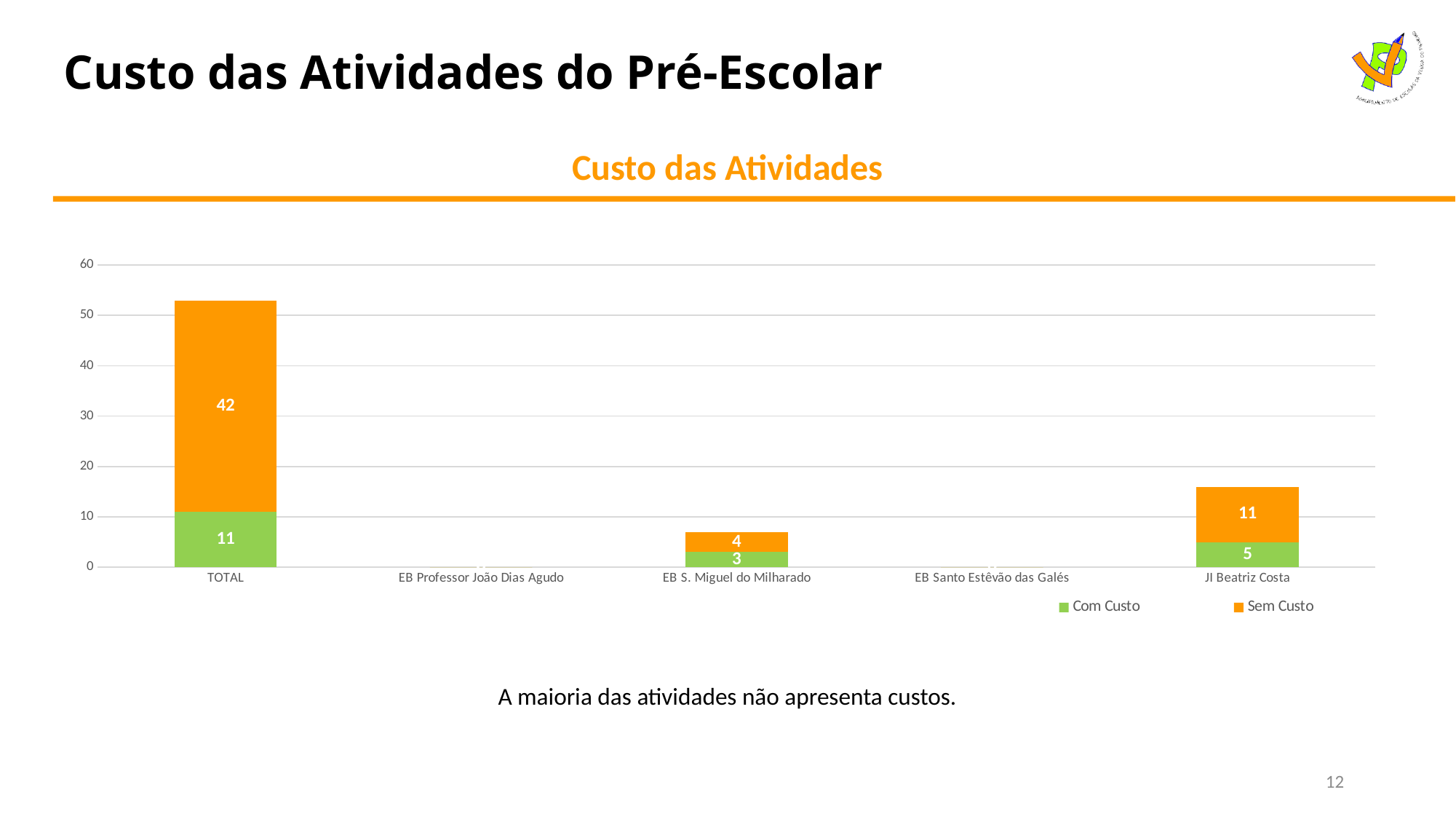
What is the Com Custo value for JI Beatriz Costa? 5 How many series does the legend list? 2 Which school (excluding TOTAL) has the highest Sem Custo value? JI Beatriz Costa What is the Sem Custo value for EB S. Miguel do Milharado? 4 What is the Com Custo value for TOTAL? 11 What is the total of the stacked bar for EB S. Miguel do Milharado? 7 What is the total of the stacked bar for JI Beatriz Costa? 16 Is the total stacked bar for TOTAL greater or less than 50? greater What is the difference between the Sem Custo and Com Custo values for JI Beatriz Costa? 6 Which is larger for EB S. Miguel do Milharado: Com Custo or Sem Custo? Sem Custo What kind of chart is shown on the slide? Stacked bar chart What is the Sem Custo value for TOTAL? 42